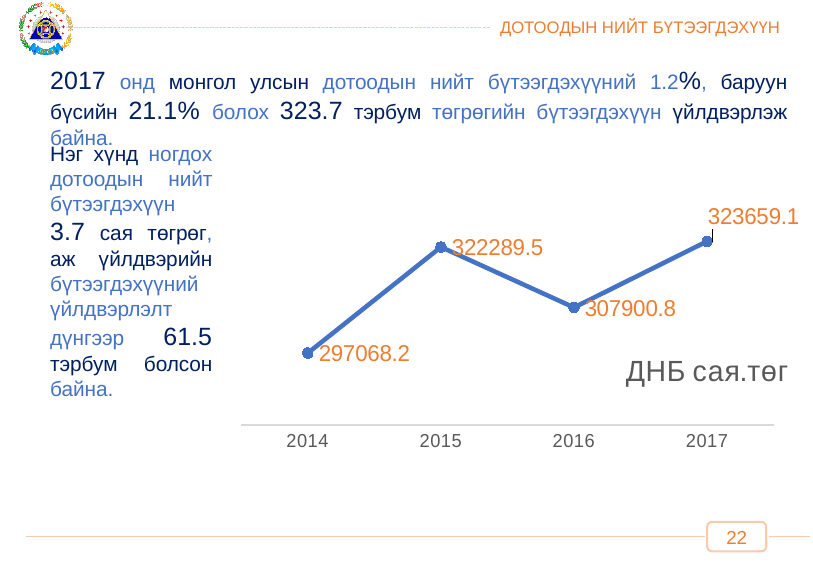
What is the value for 2017 on the line chart? 323659.1 What is the value for 2016 on the line chart? 307900.8 What is the value for 2015 on the line chart? 322289.5 What kind of chart is shown on the slide? Line chart Which is larger on the line chart, the value for 2015 or the value for 2016? 2015 What is the value for 2014 on the line chart? 297068.2 What is the difference between the 2017 value and the 2016 value on the line chart? 15758.3 How many data points are plotted on the line chart? 4 Which year has the highest value on the line chart? 2017 Which year has the lowest value on the line chart? 2014 What is the difference between the 2015 value and the 2014 value on the line chart? 25221.3 What is the label shown on the chart area of the line chart? ДНБ сая.төг